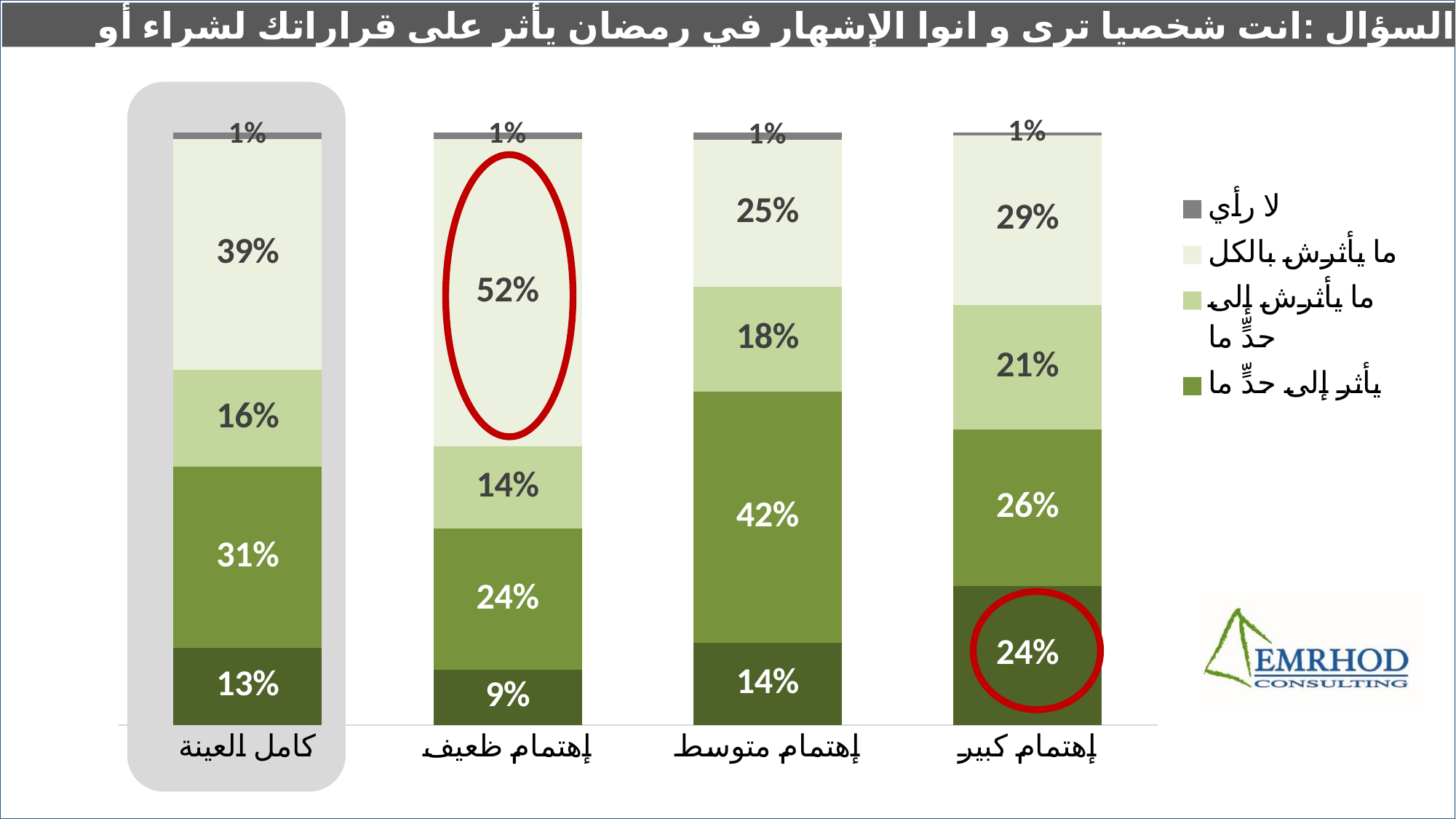
What is the value of ما يأثرش إلى حدٍّ ما for كامل العينة? 16% What is the value of ما يأثرش بالكل for إهتمام ظعيف? 52% How many categories are shown on the x axis? 4 What is the value of ما يأثرش إلى حدٍّ ما for إهتمام كبير? 21% Which category has the highest value for ما يأثرش بالكل? إهتمام ظعيف Which category has the lowest value for يأثر إلى حدٍّ ما? إهتمام ظعيف What is the value of يأثر إلى حدٍّ ما for إهتمام متوسط? 42% Which has the larger value for يأثر إلى حدٍّ ما: إهتمام متوسط or إهتمام كبير? إهتمام متوسط How many series does the legend list? 4 Which category is highlighted with a grey rounded box? كامل العينة What is the difference in ما يأثرش بالكل between إهتمام ظعيف and إهتمام كبير? 23 percentage points What kind of chart is shown on the slide? Stacked bar chart